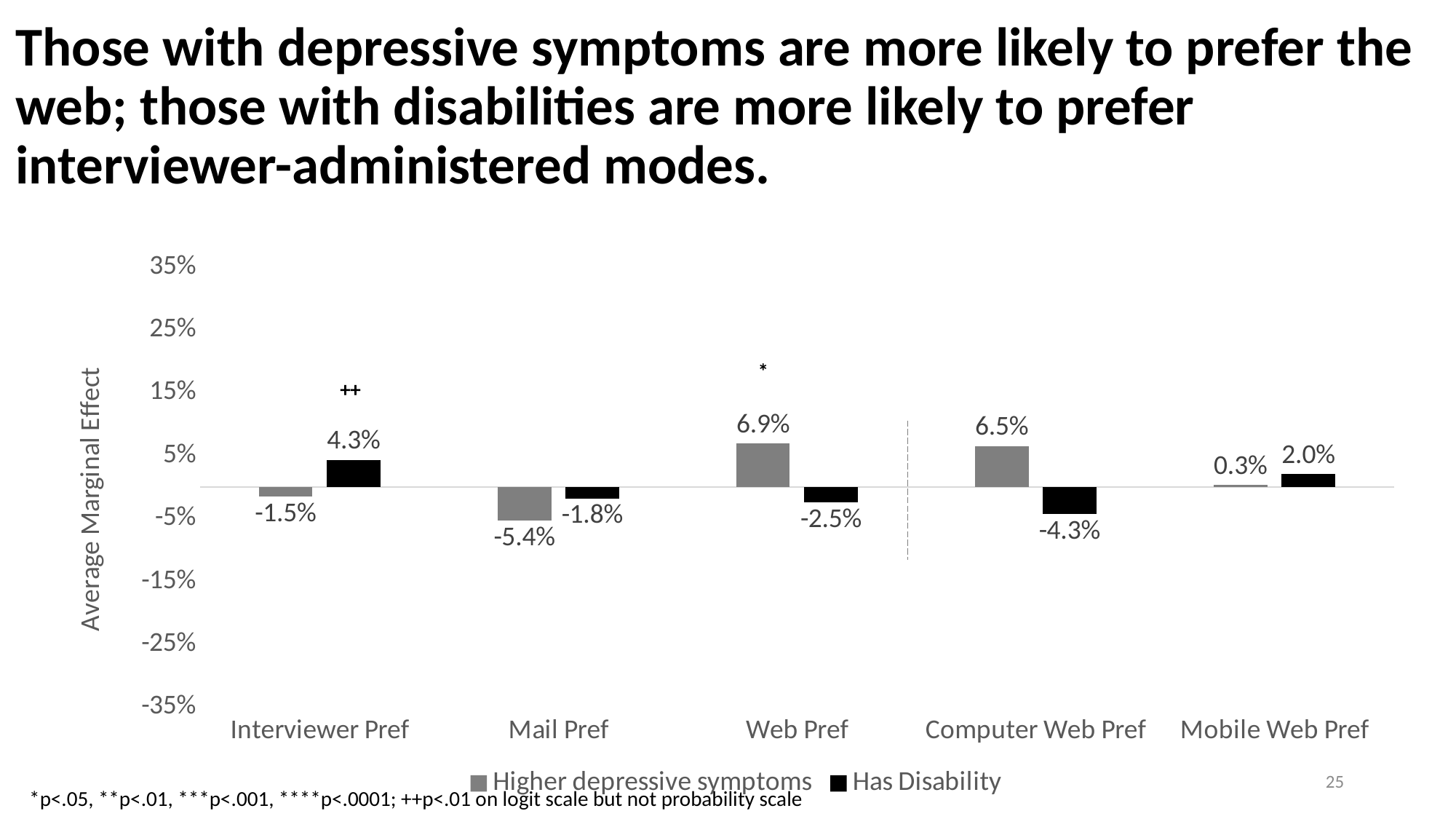
At Mobile Web Pref, which series has the larger value: Higher depressive symptoms or Has Disability? Has Disability How many series does the legend list? 2 What is the value for Has Disability at Computer Web Pref? -4.3% Which category has the lowest value for Has Disability? Computer Web Pref What is the difference between the Higher depressive symptoms value and the Has Disability value at Web Pref? 9.4% Which category has the highest value for Higher depressive symptoms? Web Pref What is the value for Has Disability at Interviewer Pref? 4.3% What is the value for Higher depressive symptoms at Mail Pref? -5.4% What is the value for Higher depressive symptoms at Web Pref? 6.9% What kind of chart is shown on the slide? Bar chart What is the label on the vertical axis? Average Marginal Effect How many categories are shown on the x axis? 5